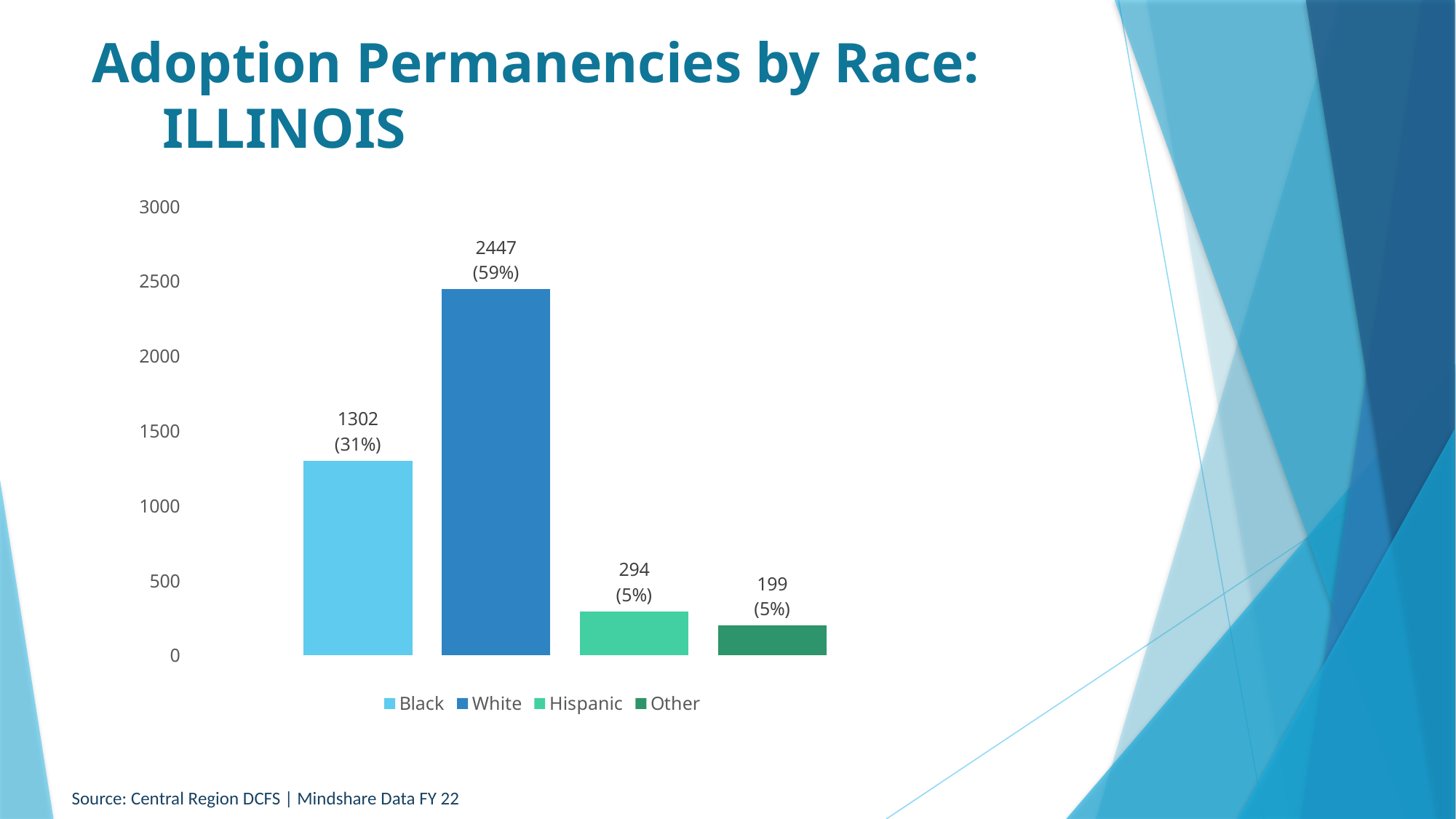
Is the value for Black greater or less than 1000? greater Which category has the highest value? White What is the difference between the values for White and Black? 1145 What is the value for Other? 199 (5%) What kind of chart is shown on the slide? Bar chart What is the value for White? 2447 (59%) What is the title of the slide? Adoption Permanencies by Race: ILLINOIS What is the value for Hispanic? 294 (5%) Which category has the lowest value? Other Which is larger, the value for Hispanic or the value for Other? Hispanic How many categories are shown in the chart? 4 What is the value for Black? 1302 (31%)